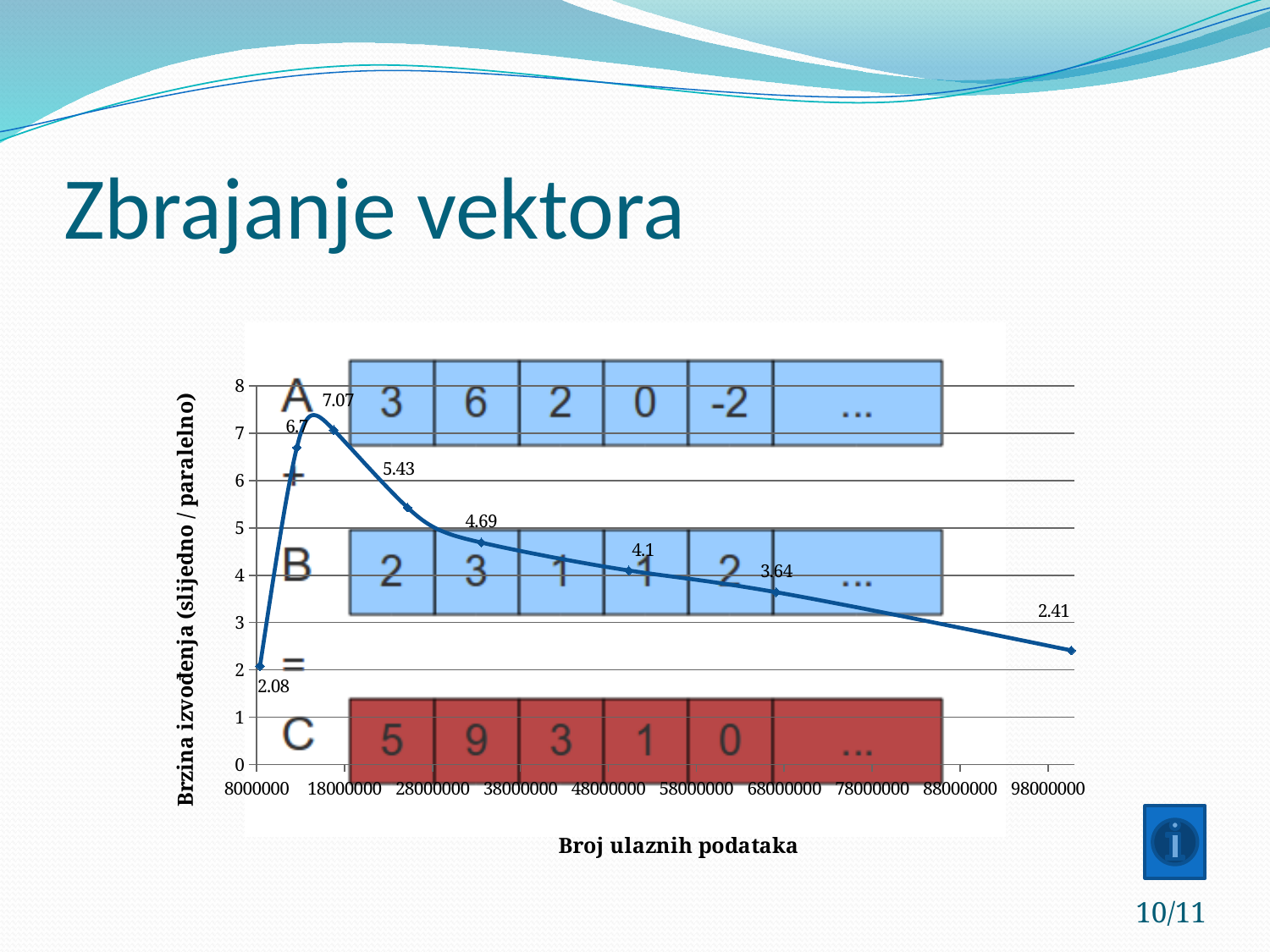
What kind of chart is shown on the slide? line chart What is the highest value labelled on the line? 7.07 Which is larger, the value labelled 4.1 or the value labelled 3.64? 4.1 What is the lowest value labelled on the line? 2.08 What is the label of the y axis? Brzina izvođenja (slijedno / paralelno) What is the difference between the highest labelled value (7.07) and the lowest labelled value (2.08)? 4.99 How many data points are plotted on the line? 8 What is the value of the first data point, at 8000000 on the x axis? 2.08 What is the value of the last data point, at the right end of the line? 2.41 What is the difference between the labelled values 5.43 and 4.69? 0.74 What is the label of the x axis? Broj ulaznih podataka After reaching its peak of 7.07, do the values rise or fall as the x axis increases? fall